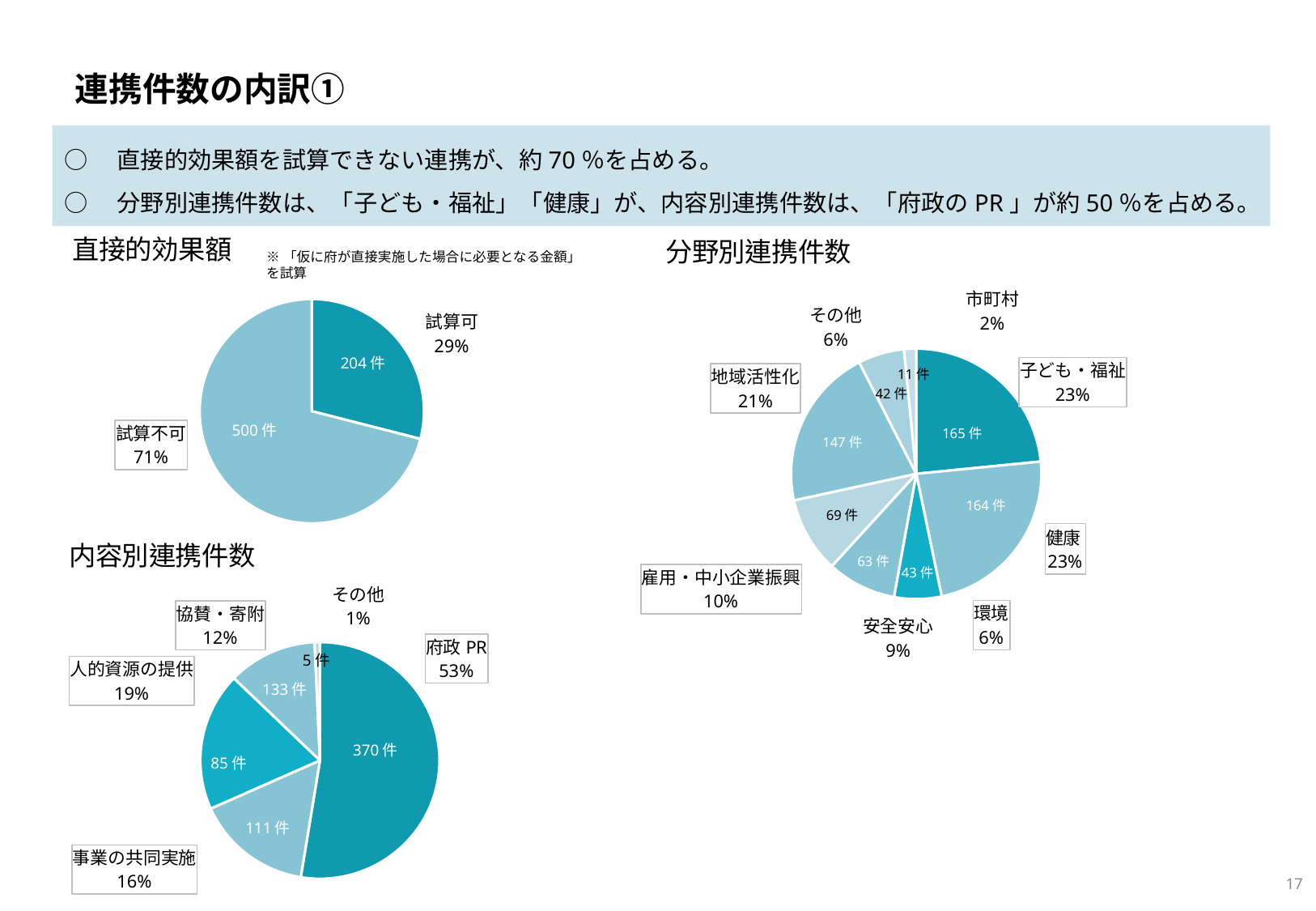
In the 直接的効果額 chart, what is the difference in 件 between 試算不可 and 試算可? 296件 In the 分野別連携件数 chart, what share of the pie is 雇用・中小企業振興? 10% In the 内容別連携件数 chart, which category has the largest slice? 府政PR In the 分野別連携件数 chart, which category has the smallest slice? 市町村 In the 内容別連携件数 chart, what share of the pie is その他? 1% In the 分野別連携件数 chart, how many 件 are in the 地域活性化 slice? 147件 In the 直接的効果額 chart, what share of the pie is 試算可? 29% In the 直接的効果額 chart, how many 件 are in the 試算不可 slice? 500件 In the 分野別連携件数 chart, which is larger, 安全安心 or 環境? 安全安心 In the 内容別連携件数 chart, how many 件 are in the 府政PR slice? 370件 In the 分野別連携件数 chart, how many categories are shown? 8 What kind of chart is the 直接的効果額 chart? pie chart